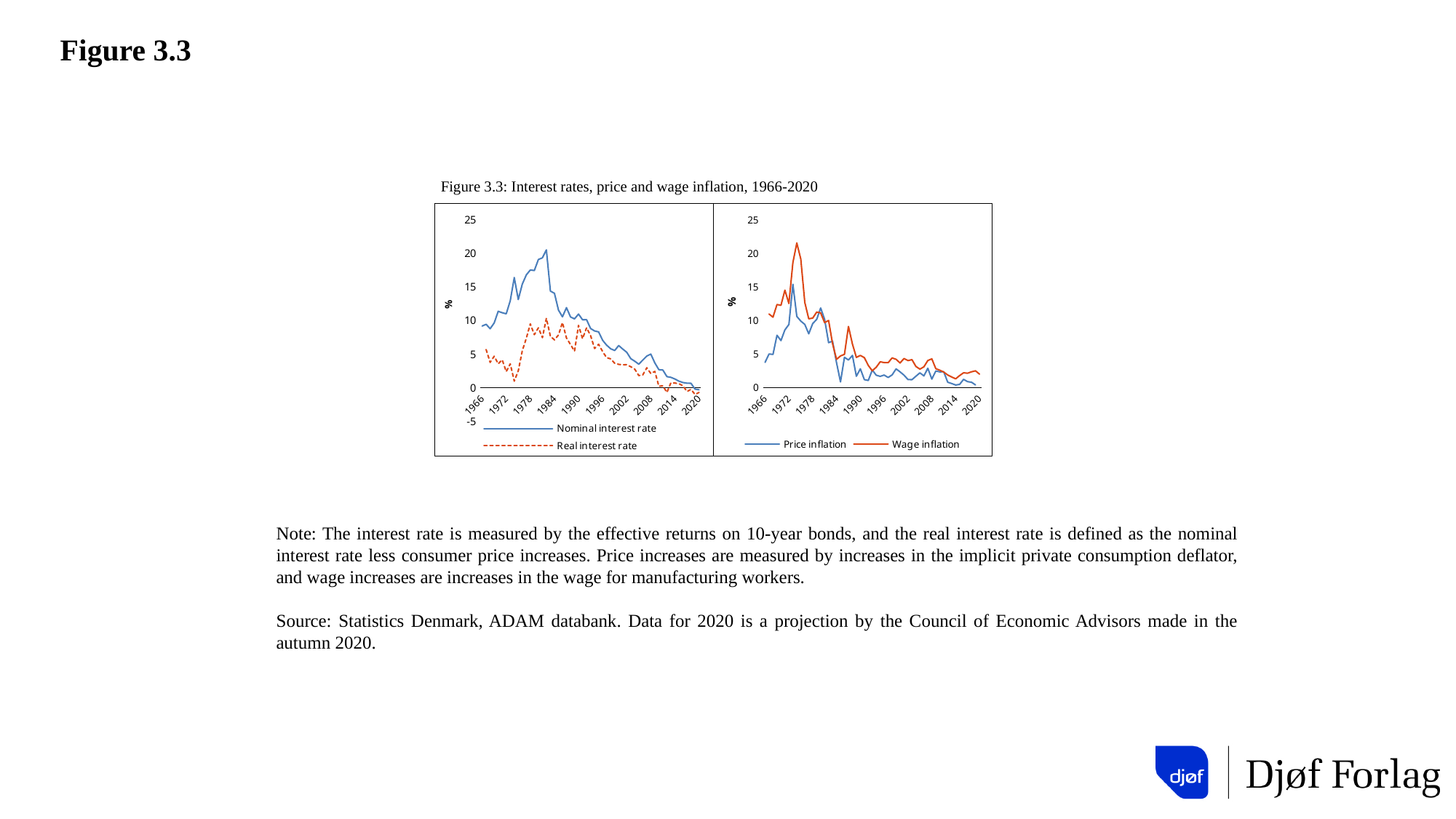
How many series does the legend of the left chart list? 2 In the left chart, does the nominal interest rate rise or fall overall from 1984 to 2020? fall What kind of chart is the left chart on the slide? line chart In the left chart, is the peak value of the nominal interest rate greater or less than 15? greater How many series does the legend of the right chart list? 2 In the left chart, is the nominal interest rate in 2020 greater or less than 5? less What is the title of the figure shown on the slide? Figure 3.3: Interest rates, price and wage inflation, 1966-2020 In the right chart, is the peak value of wage inflation greater or less than 15? greater